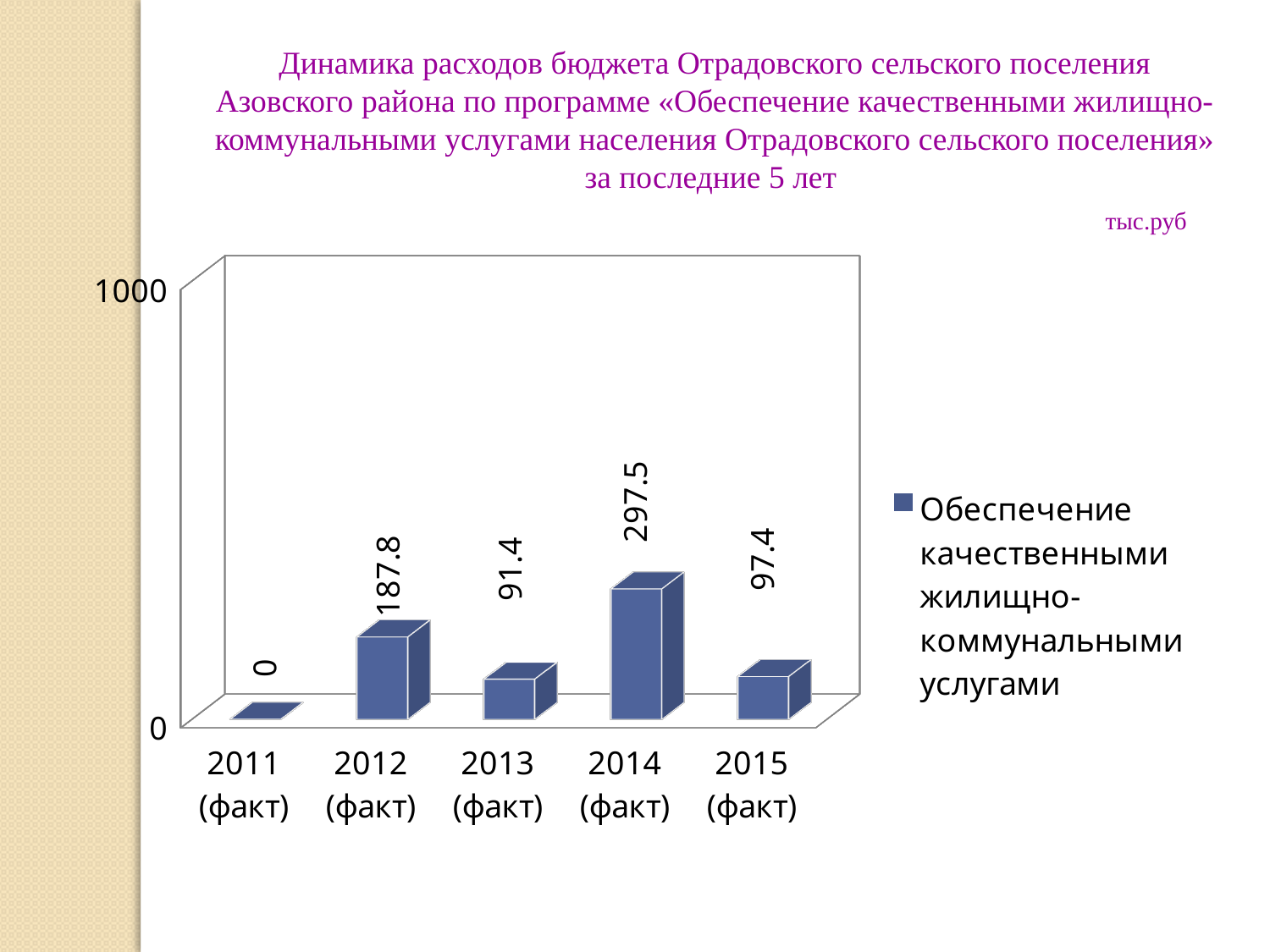
Which year has the lowest value? 2011 (факт) How many series does the legend list? 1 What is the difference between the values for 2014 (факт) and 2013 (факт)? 206.1 What is the value for 2014 (факт)? 297.5 What is the value for 2012 (факт)? 187.8 What is the value for 2015 (факт)? 97.4 What unit is indicated above the chart? тыс.руб Which is larger, the value for 2012 (факт) or the value for 2015 (факт)? 2012 (факт) Which year has the highest value? 2014 (факт) How many years are shown on the x axis? 5 What is the value for 2011 (факт)? 0 What kind of chart is shown on the slide? Bar chart